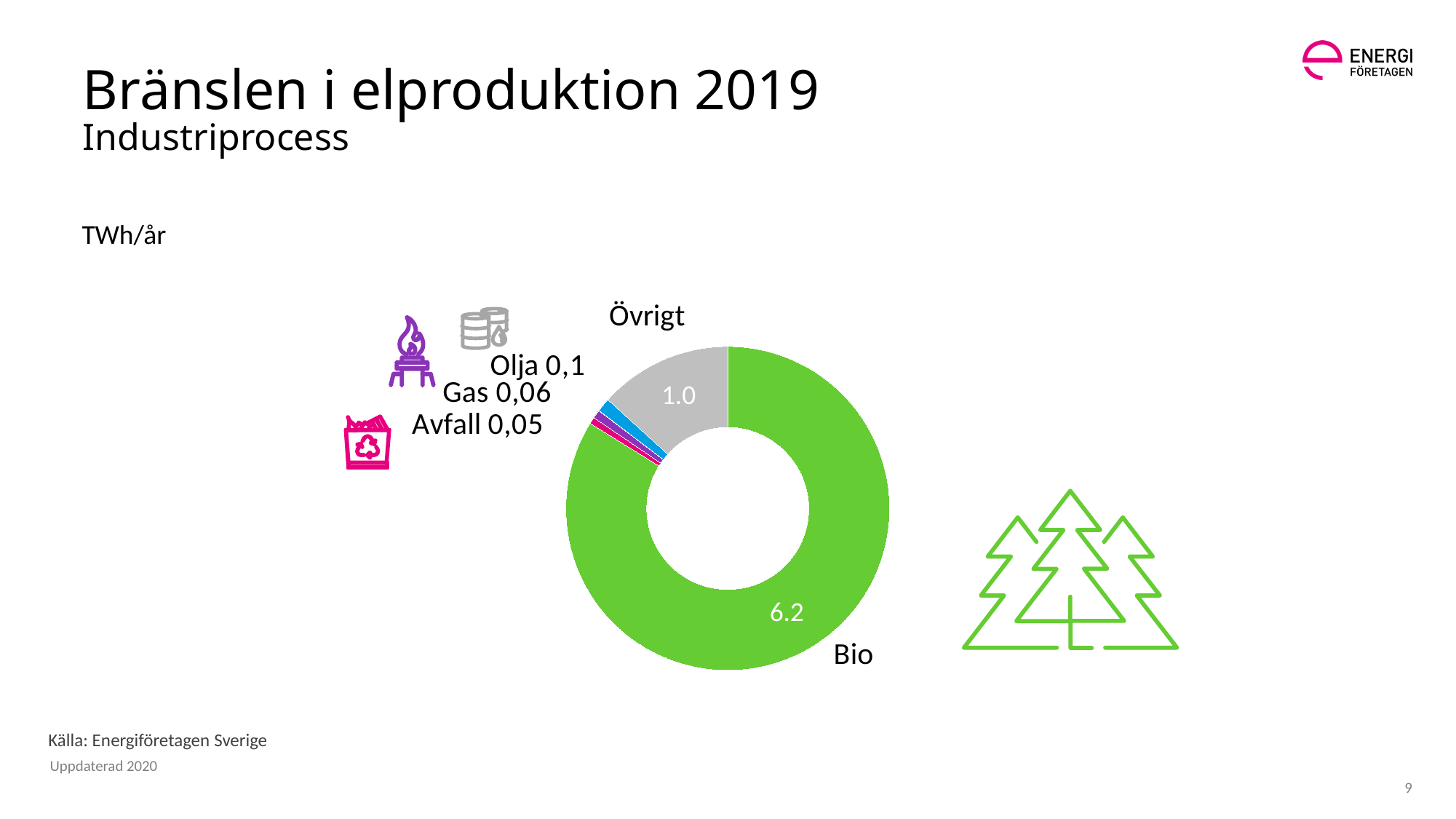
What value is shown for Bio in the donut chart? 6.2 How many categories are shown in the donut chart? 5 Which category has the smallest value in the chart? Avfall What is the difference between the values for Bio and Övrigt? 5.2 What value is shown for Avfall in the chart? 0,05 What value is shown for Gas in the chart? 0,06 What unit is stated for the values in the chart? TWh/år What value is shown for Övrigt in the donut chart? 1.0 What kind of chart is shown on the slide? Donut (pie) chart Which category has the largest share of the donut chart? Bio What value is shown for Olja in the chart? 0,1 Which is larger, the value for Olja or the value for Gas? Olja